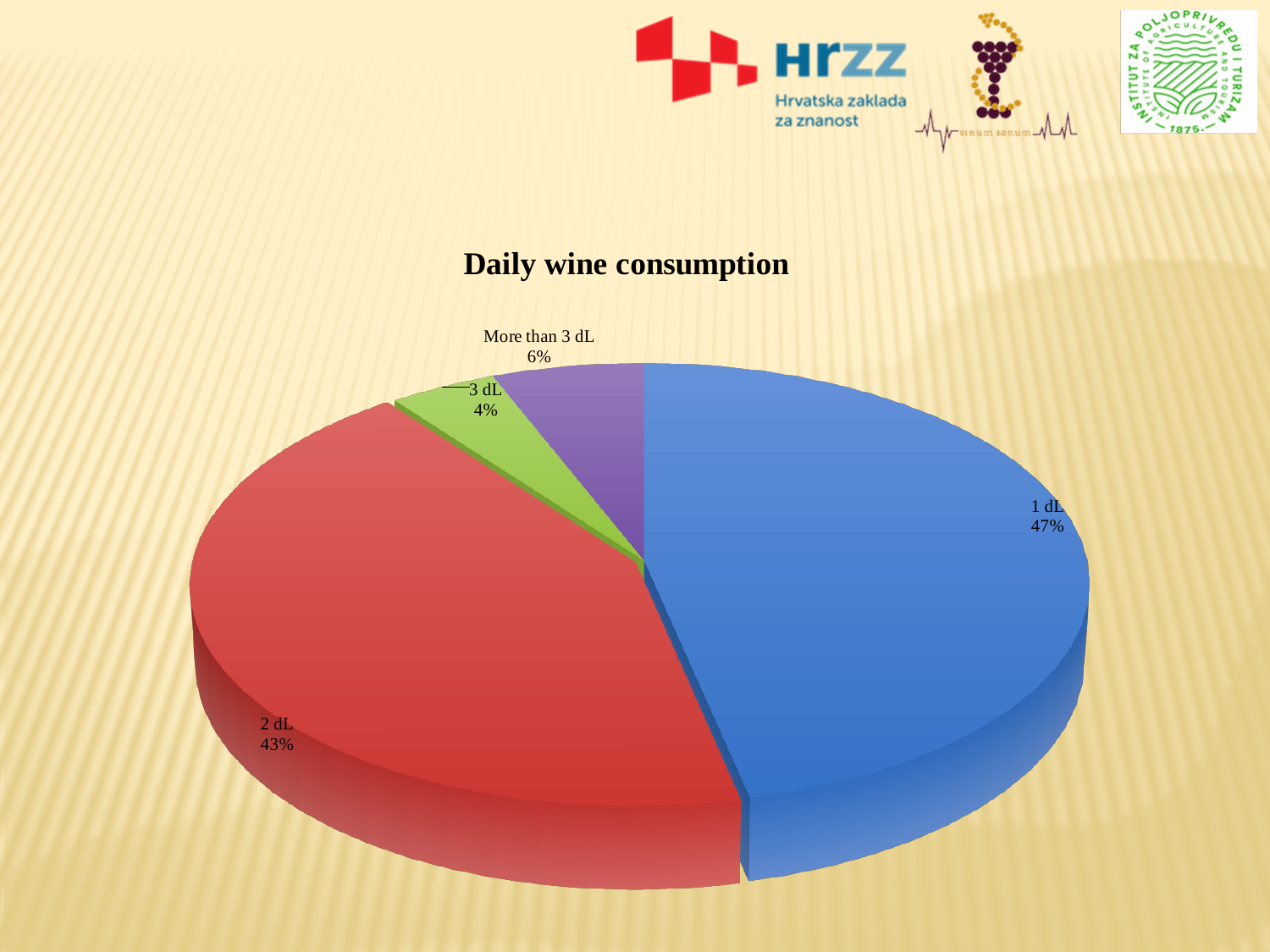
What is the difference in percentage points between the 1 dL and 2 dL slices? 4 Which category has the largest slice of the pie? 1 dL What colour is the 2 dL slice? red Which is larger, the slice for 3 dL or the slice for More than 3 dL? More than 3 dL What is the title of the chart? Daily wine consumption Which category has the smallest slice of the pie? 3 dL What share of the pie does the 2 dL slice represent? 43% What type of chart is shown on the slide? pie chart What share of the pie does the 1 dL slice represent? 47% What is the value shown for More than 3 dL? 6% How many slices does the pie chart have? 4 What is the value shown for 3 dL? 4%